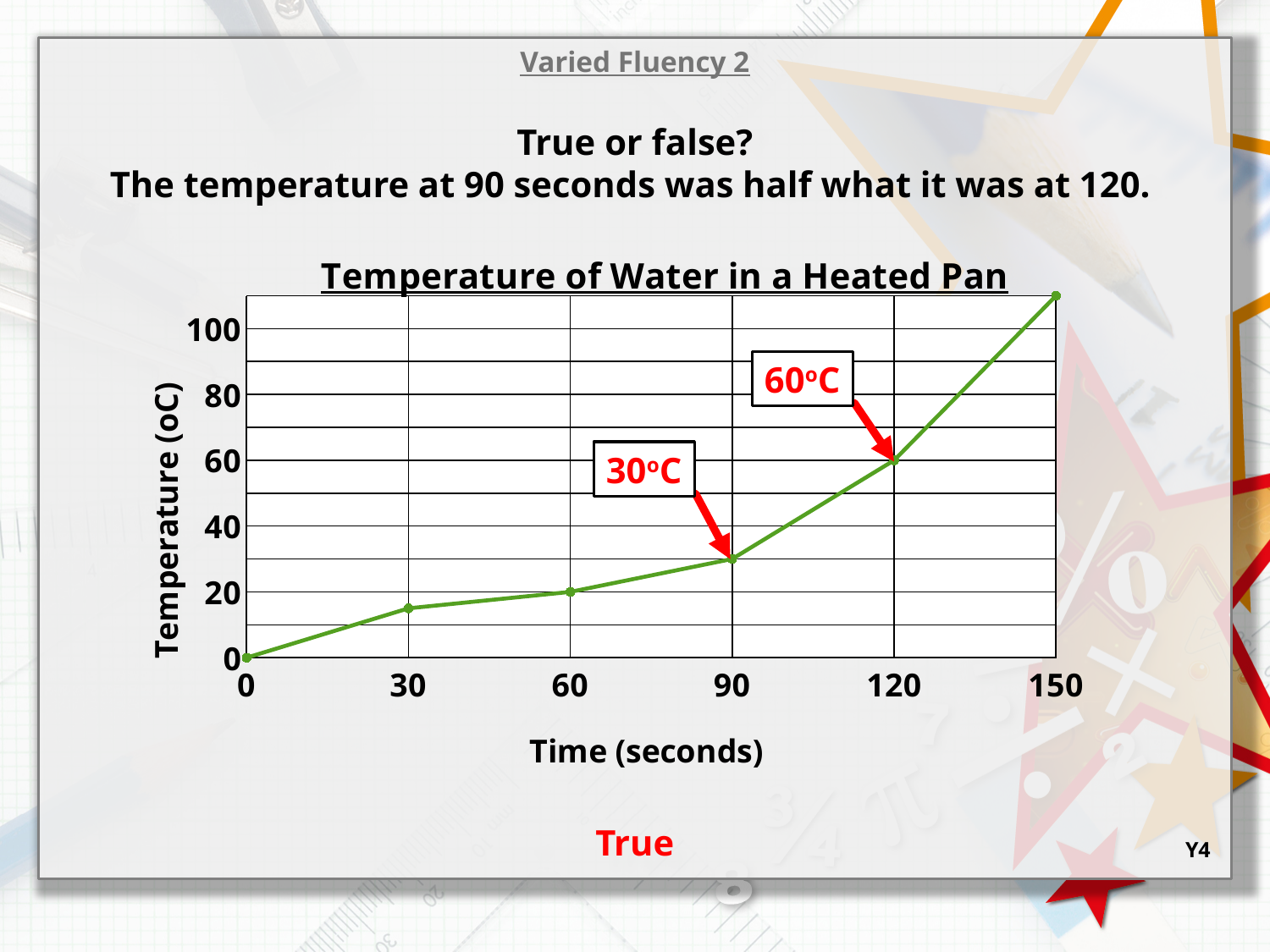
What is the difference between the temperature at 120 seconds and the temperature at 90 seconds? 30°C What was the temperature at 0 seconds? 0 What was the temperature at 120 seconds? 60°C At which time was the temperature highest? 150 seconds Is the temperature at 30 seconds greater or less than 20? less What was the temperature at 90 seconds? 30°C What was the temperature at 60 seconds? 20 Is the temperature at 150 seconds greater or less than 100? greater How many data points are plotted on the chart? 6 What type of chart is shown on the slide? Line chart At which time was the temperature lowest? 0 seconds Which time had the higher temperature, 90 seconds or 120 seconds? 120 seconds